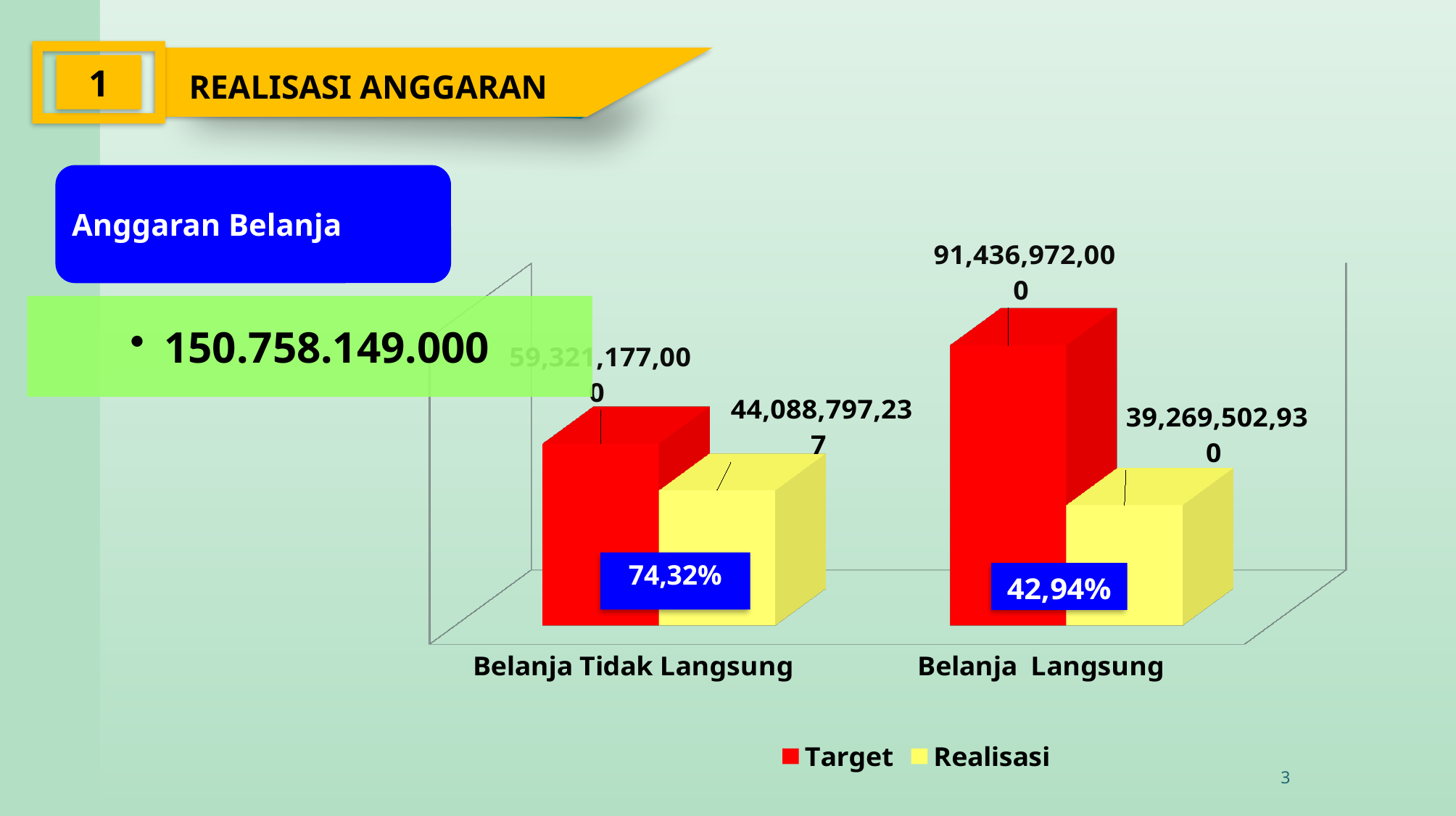
Which category has the lowest Realisasi value? Belanja Langsung What is the difference between the Realisasi values for Belanja Tidak Langsung and Belanja Langsung? 4,819,294,307 What is the difference between the Target and Realisasi values for Belanja Langsung? 52,167,469,070 Which is larger: the Realisasi value for Belanja Tidak Langsung or the Realisasi value for Belanja Langsung? Belanja Tidak Langsung What is the Realisasi value for Belanja Langsung? 39,269,502,930 How many series does the chart legend list? 2 What is the Realisasi value for Belanja Tidak Langsung? 44,088,797,237 Which category has the highest Target value? Belanja Langsung What is the Target value for Belanja Tidak Langsung? 59,321,177,000 What is the Target value for Belanja Langsung? 91,436,972,000 How many categories are shown on the x axis of the chart? 2 What percentage label is shown over the Belanja Langsung bars? 42,94%